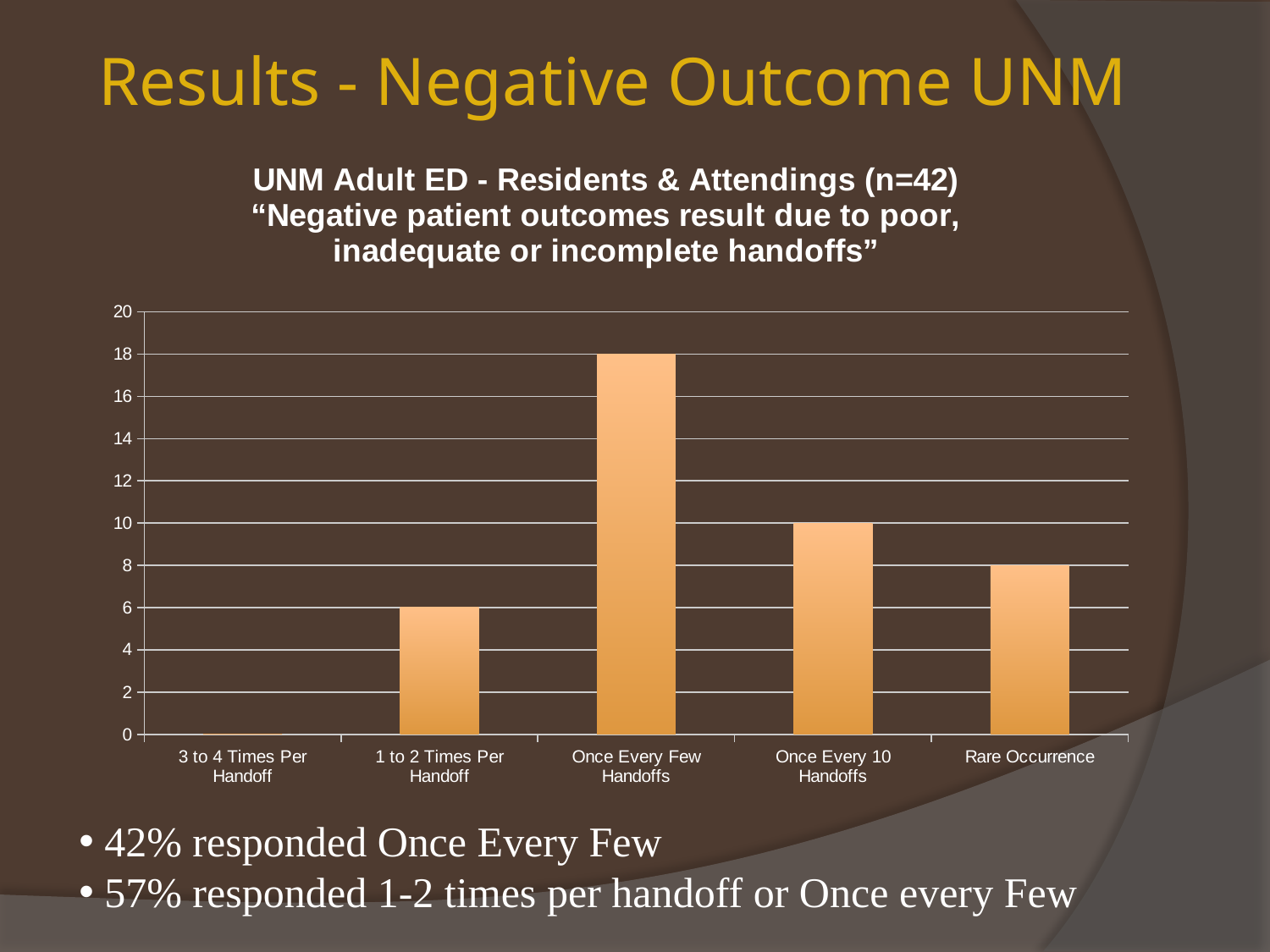
Which category has the lowest value in the chart? 3 to 4 Times Per Handoff How many categories are shown on the x axis of the chart? 5 What kind of chart is shown on the slide? bar chart What is the maximum value shown on the y axis of the chart? 20 What is the value for 1 to 2 Times Per Handoff? 6 Is the value for Once Every Few Handoffs greater or less than 16? greater What is the difference between the values for Once Every Few Handoffs and Once Every 10 Handoffs? 8 What is the value for Once Every 10 Handoffs? 10 What is the value for Rare Occurrence? 8 Which is larger, the value for Once Every 10 Handoffs or the value for Rare Occurrence? Once Every 10 Handoffs What is the value for Once Every Few Handoffs? 18 Which category has the highest value in the chart? Once Every Few Handoffs